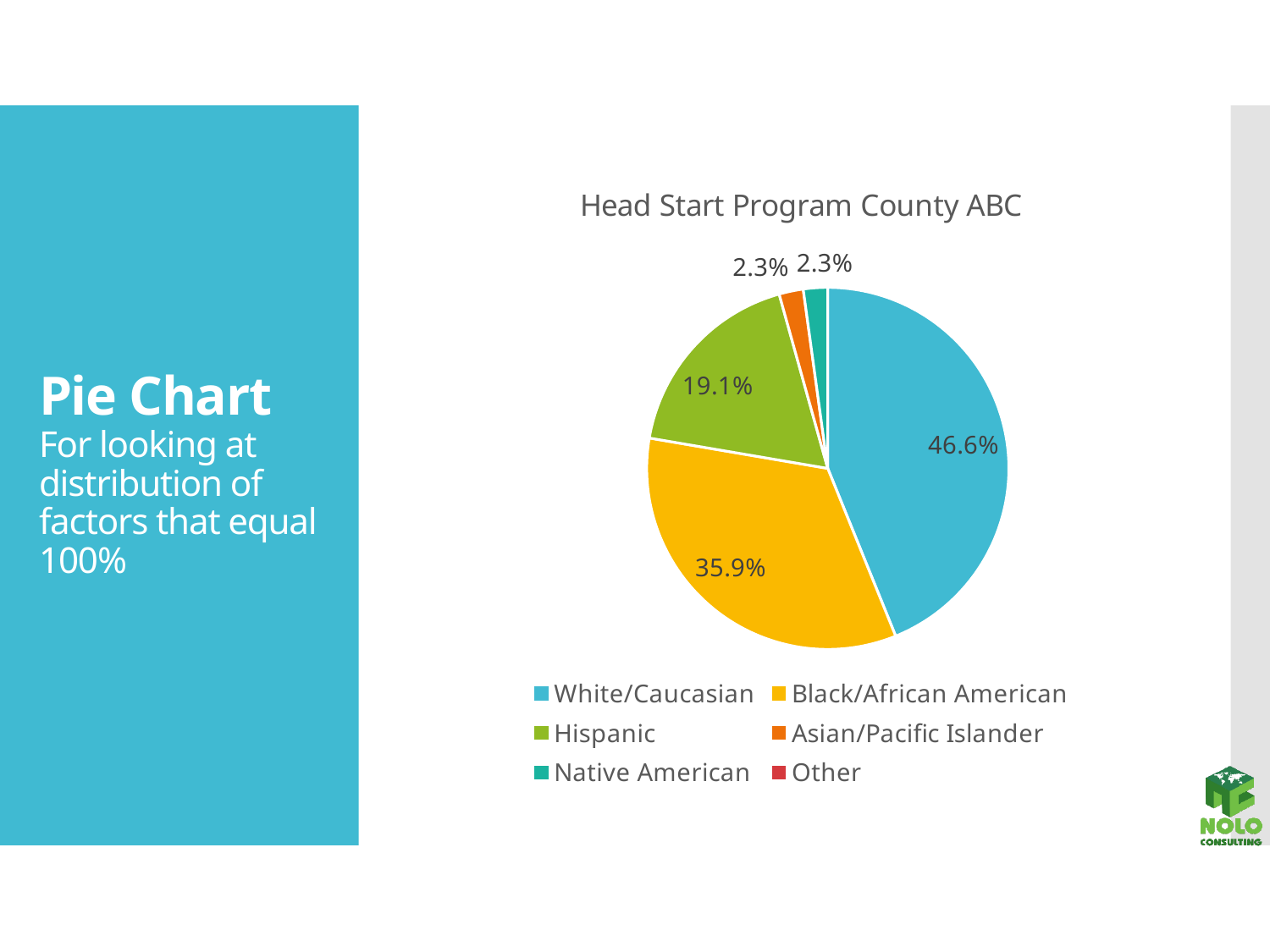
What is the title of the chart? Head Start Program County ABC What is the difference in percentage points between White/Caucasian and Black/African American? 10.7 How many categories does the legend list? 6 What percentage is shown for Asian/Pacific Islander? 2.3% What is the difference in percentage points between Black/African American and Hispanic? 16.8 What share of the pie does the Hispanic slice represent? 19.1% What percentage is shown for Hispanic? 19.1% What percentage is shown for Black/African American? 35.9% What percentage is shown for White/Caucasian? 46.6% Which category has the largest slice of the pie? White/Caucasian What type of chart is shown on the slide? Pie chart Which is larger, the Hispanic slice or the Black/African American slice? Black/African American